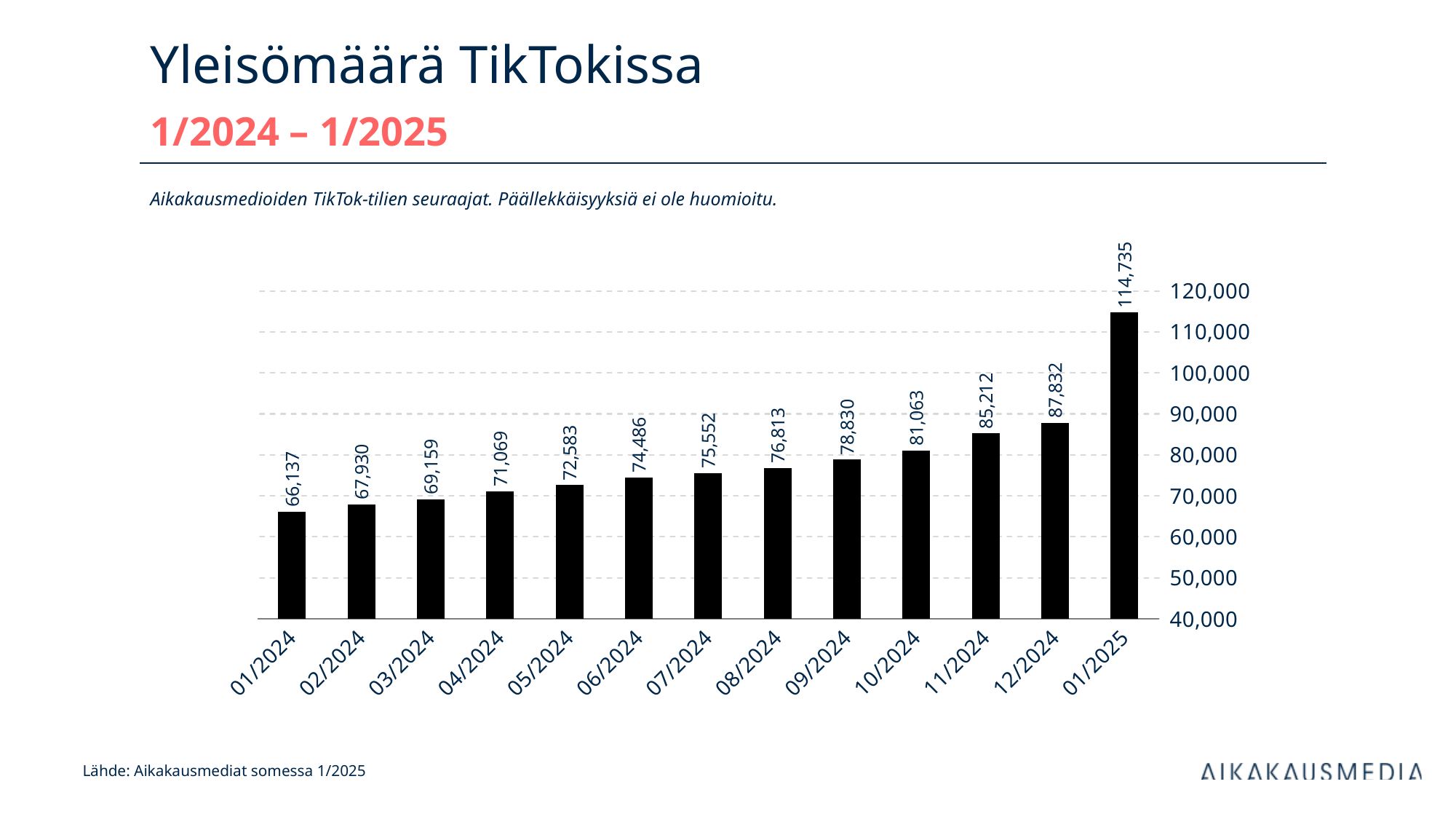
What kind of chart is shown on the slide? bar chart What is the difference between the values for 01/2025 and 12/2024? 26,903 Which month has the lowest value? 01/2024 What is the value for 12/2024? 87,832 Which is larger, the value for 05/2024 or the value for 09/2024? 09/2024 Which month has the highest value? 01/2025 Do the values rise or fall from 01/2024 to 01/2025? rise What is the value for 07/2024? 75,552 What is the difference between the values for 01/2025 and 01/2024? 48,598 What is the value for 01/2024? 66,137 How many months are shown on the x axis? 13 Is the value for 11/2024 greater or less than 80,000? greater